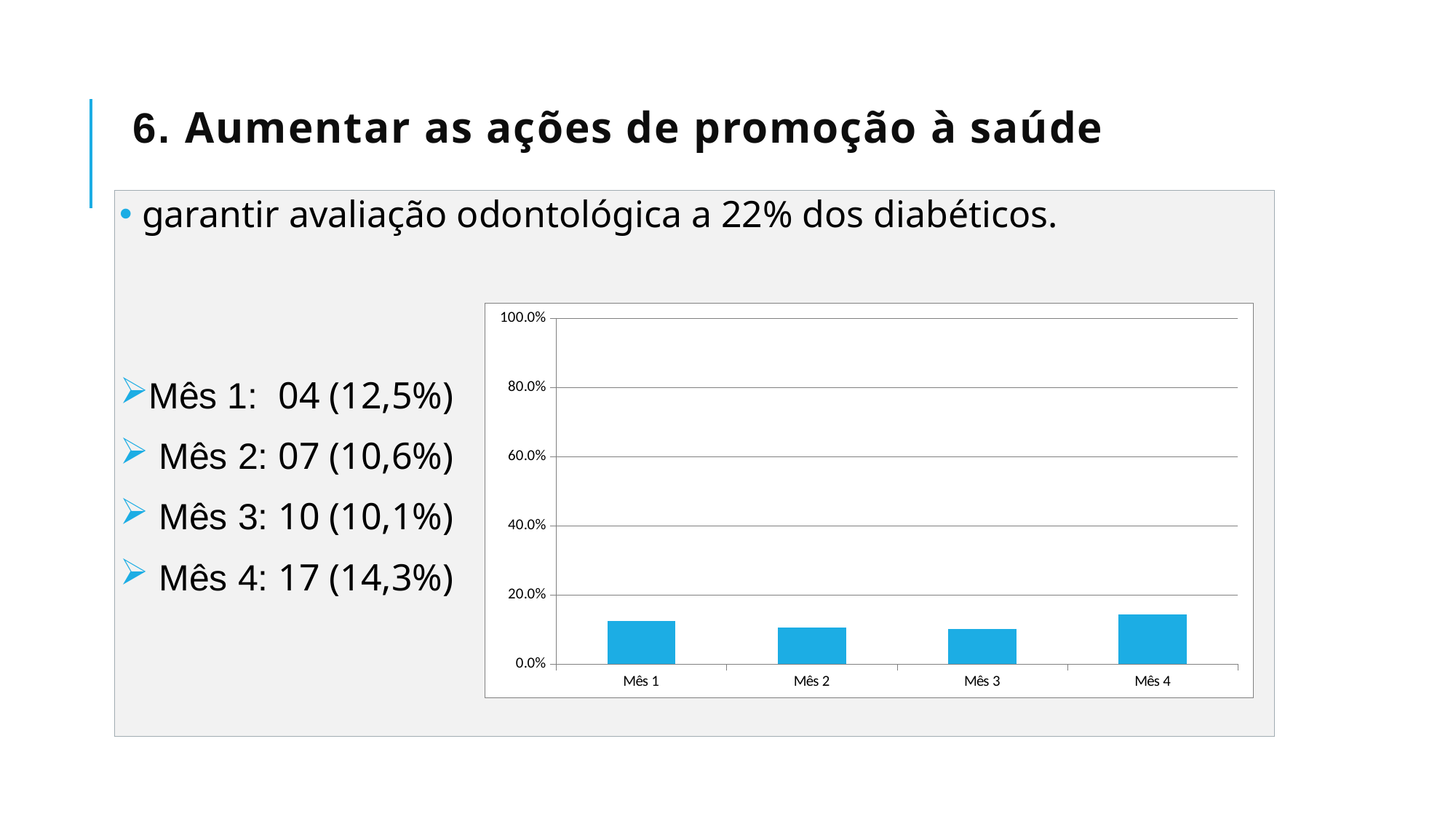
What kind of chart is shown on the slide? bar chart According to the slide, what percentage is shown for Mês 4? 14,3% Is the value for Mês 4 greater or less than 20%? less What colour are the bars in the chart? blue What is the highest value shown on the y axis of the chart? 100.0% How many categories (months) are shown on the x axis of the chart? 4 Which month has the highest bar in the chart? Mês 4 Which is larger, the bar for Mês 1 or the bar for Mês 3? Mês 1 Which is larger, the bar for Mês 1 or the bar for Mês 4? Mês 4 According to the slide, what percentage is shown for Mês 2? 10,6% According to the slide, what percentage is shown for Mês 1? 12,5% Is the value for Mês 1 greater or less than 20%? less